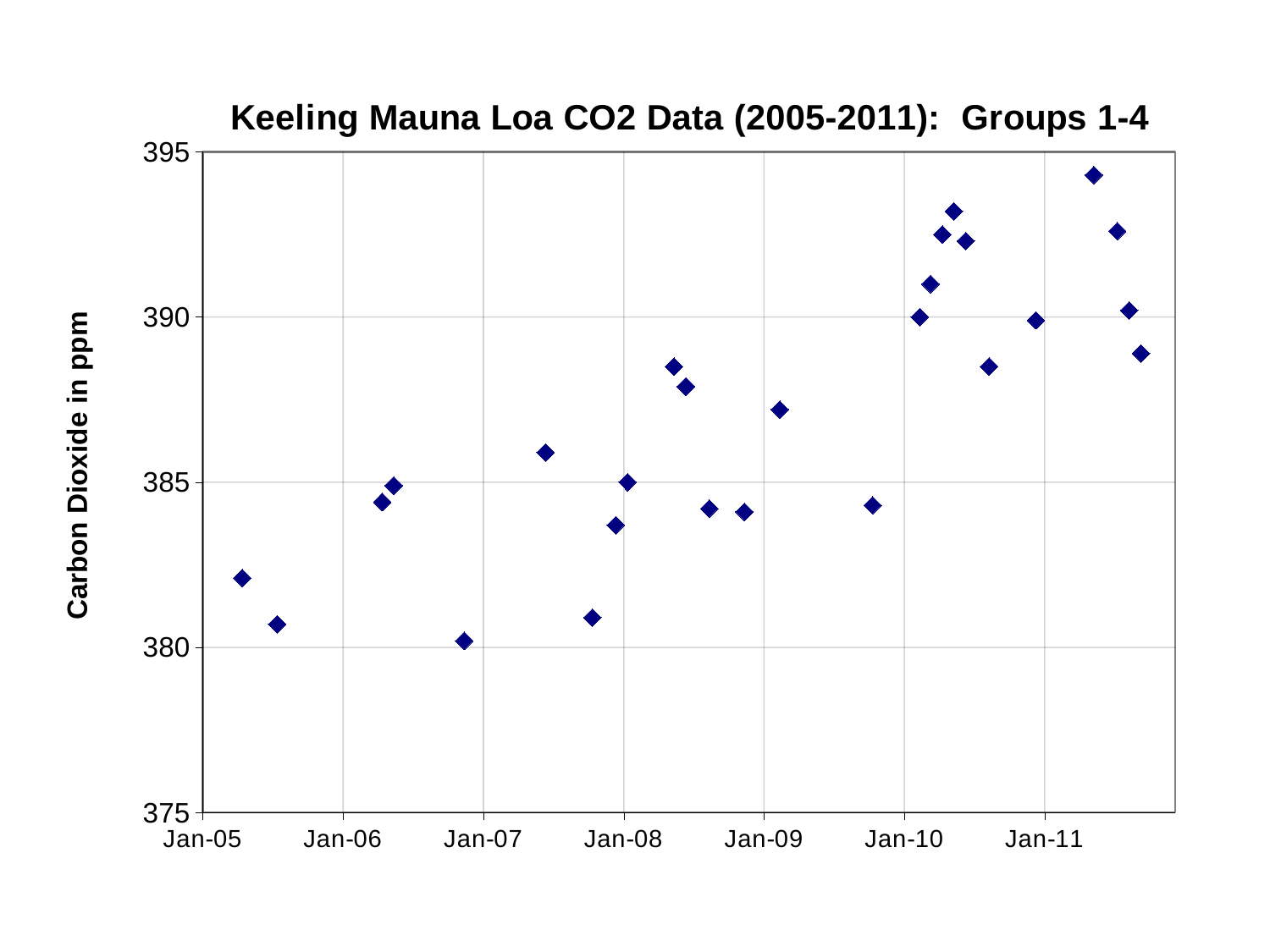
Do the plotted CO2 values generally rise or fall from Jan-05 to Jan-11? rise Which has the larger CO2 value: the point at Jan-10 or the first point after Jan-05? Jan-10 What is the lowest value shown on the vertical axis? 375 What is the title of the chart? Keeling Mauna Loa CO2 Data (2005-2011): Groups 1-4 Is the first plotted point (just after Jan-05) greater or less than 380? greater Is the lowest plotted point greater or less than 385? less Is the point plotted at Jan-10 greater or less than 385? greater What kind of chart is shown on the slide? scatter chart How many data points are plotted on the chart? 26 What is the label of the vertical axis? Carbon Dioxide in ppm